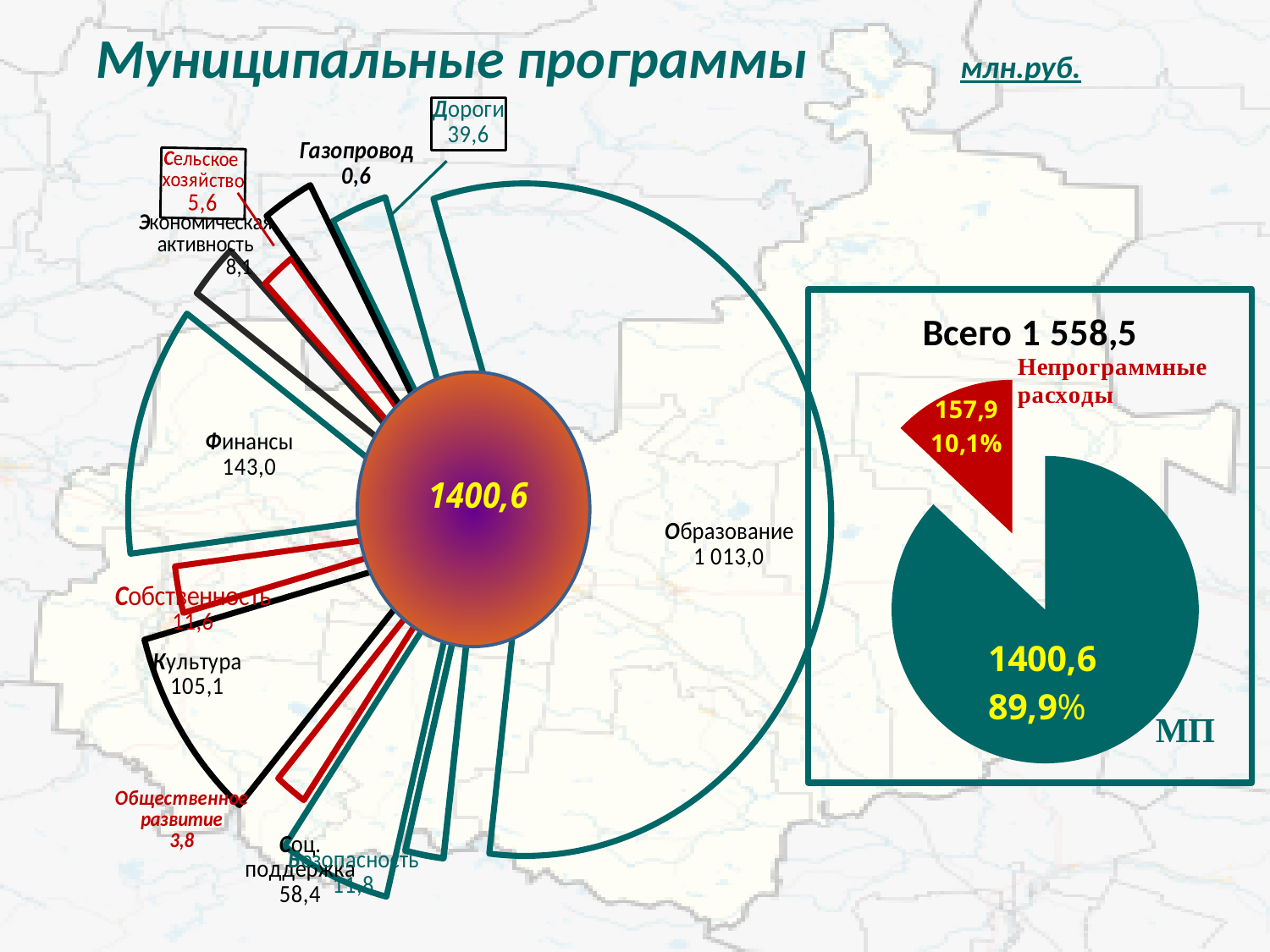
On the right pie chart, what is the value for Непрограммные расходы? 157,9 On the left radial chart, which program has the lowest value? Газопровод On the right pie chart, what is the total (Всего) shown above the pie? 1 558,5 On the left radial chart, which program has the highest value? Образование On the left radial chart, what is the value for Образование? 1 013,0 On the left radial chart, which is larger: Культура or Соц. поддержка? Культура On the right pie chart, what share of the total do Непрограммные расходы make up? 10,1% On the left radial chart, what is the difference between Образование and Финансы? 870,0 On the right pie chart, what share of the total does МП make up? 89,9% On the left radial chart, what is the value for Финансы? 143,0 On the right pie chart, how many slices does the pie have? 2 On the right pie chart, what is the difference between the МП value and the Непрограммные расходы value? 1242,7